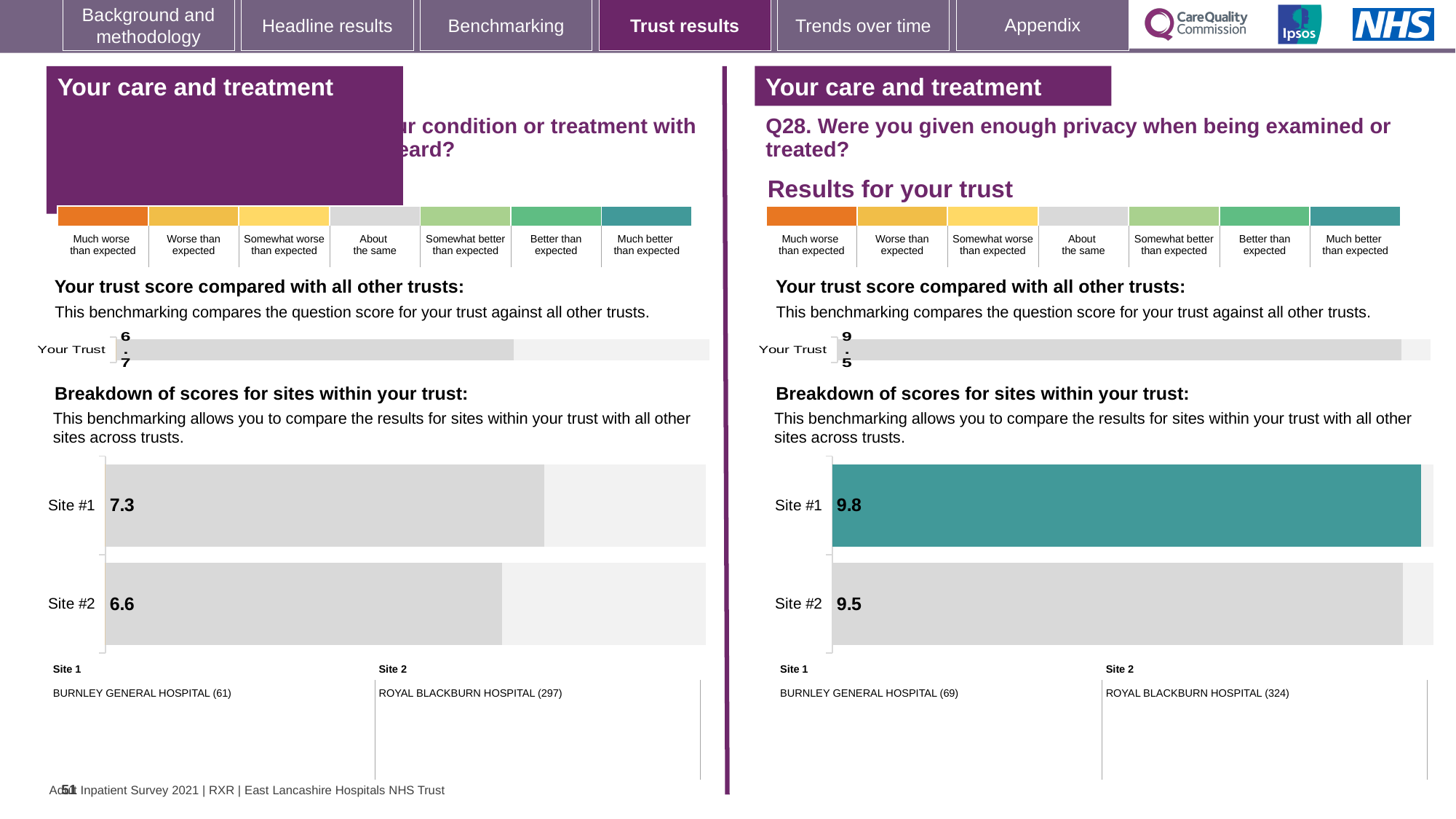
On the right-hand (Q28) site breakdown chart, what is the score for Site #2? 9.5 On the left-hand site breakdown chart, what is the score for Site #2? 6.6 On the left-hand 'Your trust score compared with all other trusts' chart, what is the score for Your Trust? 6.7 On the right-hand (Q28) site breakdown chart, what is the difference between the scores for Site #1 and Site #2? 0.3 On the right-hand (Q28) 'Your trust score compared with all other trusts' chart, what is the score for Your Trust? 9.5 What type of chart is used for the site breakdown on the left-hand side of the slide? Bar chart On the right-hand (Q28) site breakdown chart, which site has the lower score? Site #2 On the right-hand (Q28) site breakdown chart, what is the score for Site #1? 9.8 On the left-hand site breakdown chart, which site has the higher score? Site #1 On the left-hand site breakdown chart, what is the score for Site #1? 7.3 How many sites are shown on the right-hand (Q28) site breakdown chart? 2 On the left-hand site breakdown chart, what is the difference between the scores for Site #1 and Site #2? 0.7